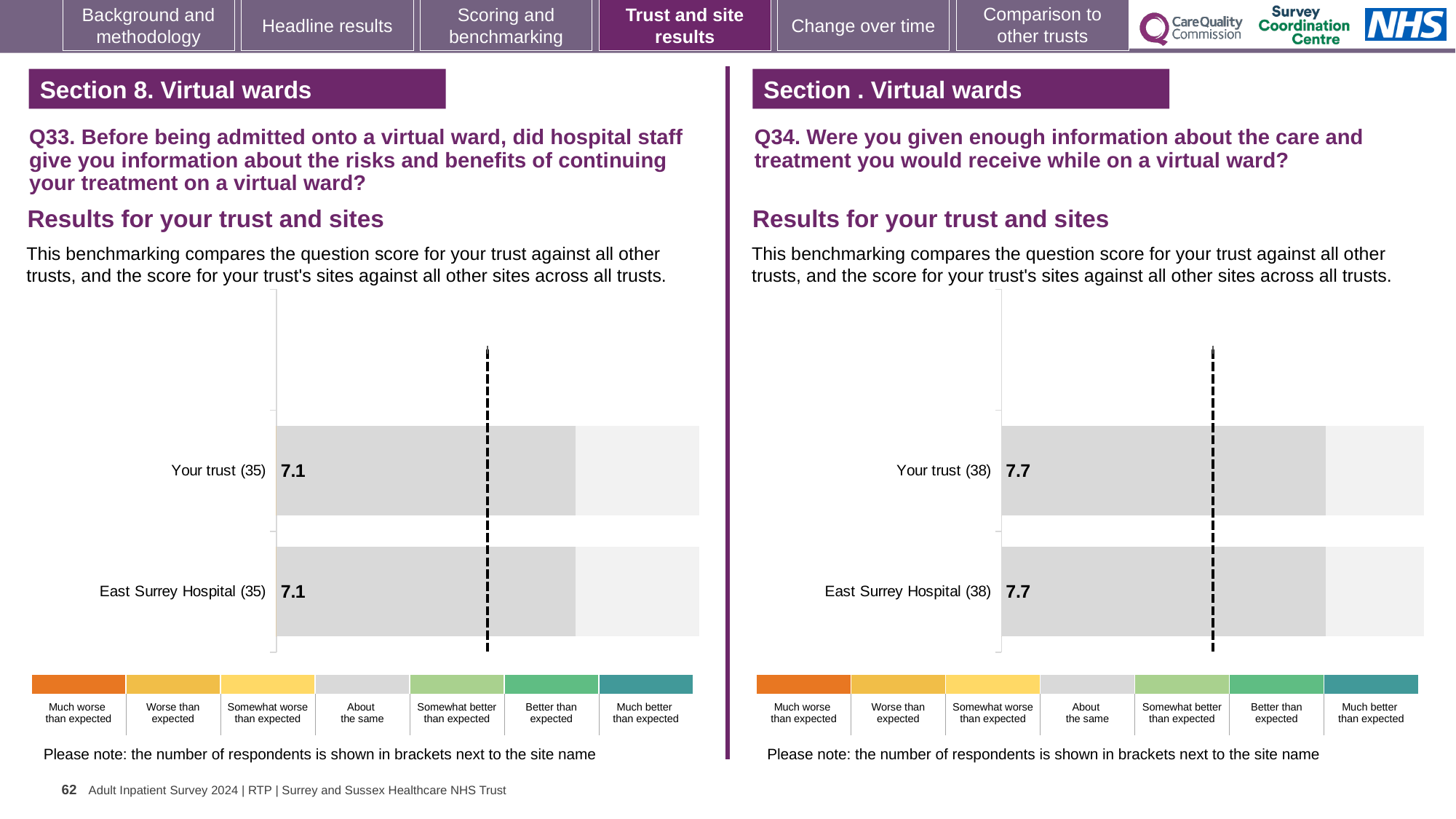
In the Q34 chart on the right, what is the score for East Surrey Hospital? 7.7 In the Q33 chart on the left, how many respondents are shown in brackets for Your trust? 35 What kind of chart is used in the Q33 chart on the left? Bar chart In the Q33 chart on the left, what is the difference between the score for Your trust and the score for East Surrey Hospital? 0 Comparing the two charts, what is the difference between the Your trust score in the Q34 chart and the Your trust score in the Q33 chart? 0.6 In the Q34 chart on the right, how many respondents are shown in brackets for East Surrey Hospital? 38 In the Q33 chart on the left, what is the score for Your trust? 7.1 In the Q33 chart on the left, how many bars are plotted? 2 In the Q34 chart on the right, how many categories are shown? 2 In the Q33 chart on the left, what is the score for East Surrey Hospital? 7.1 Comparing the two charts, is the Your trust score higher in the Q33 chart on the left or the Q34 chart on the right? Q34 chart on the right In the Q34 chart on the right, what is the score for Your trust? 7.7